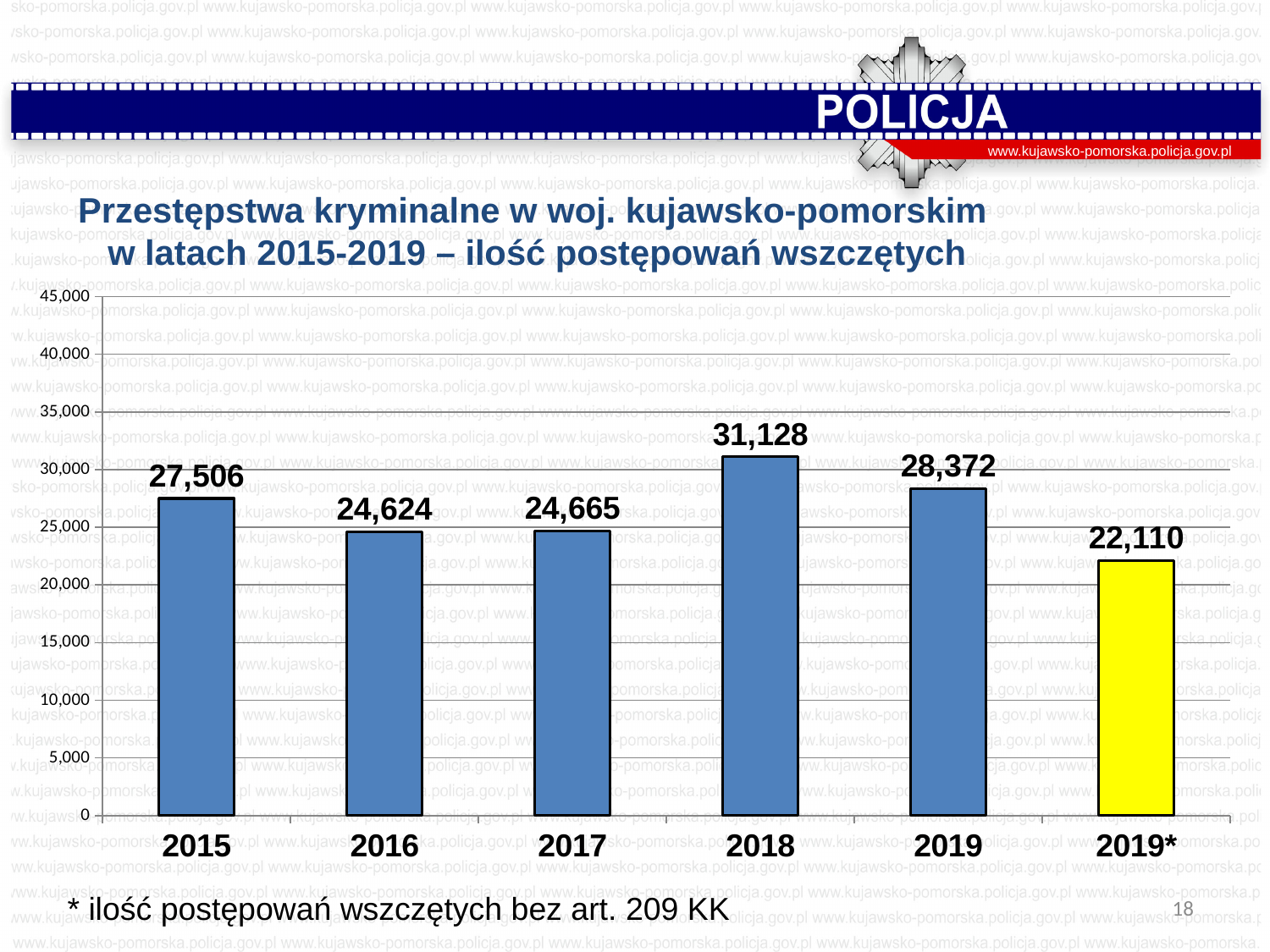
What is the value for 2015? 27,506 Which category has the lowest value? 2019* What is the value for 2019*? 22,110 What is the value for 2018? 31,128 Is the value for 2018 greater or less than 30,000? greater Which is larger, the value for 2015 or the value for 2016? 2015 Does the value rise or fall from 2018 to 2019? fall What is the difference between the values for 2018 and 2019? 2,756 How many bars are shown in the chart? 6 Which category has the highest value? 2018 What kind of chart is shown on the slide? bar chart Which bar is coloured yellow instead of blue? 2019*